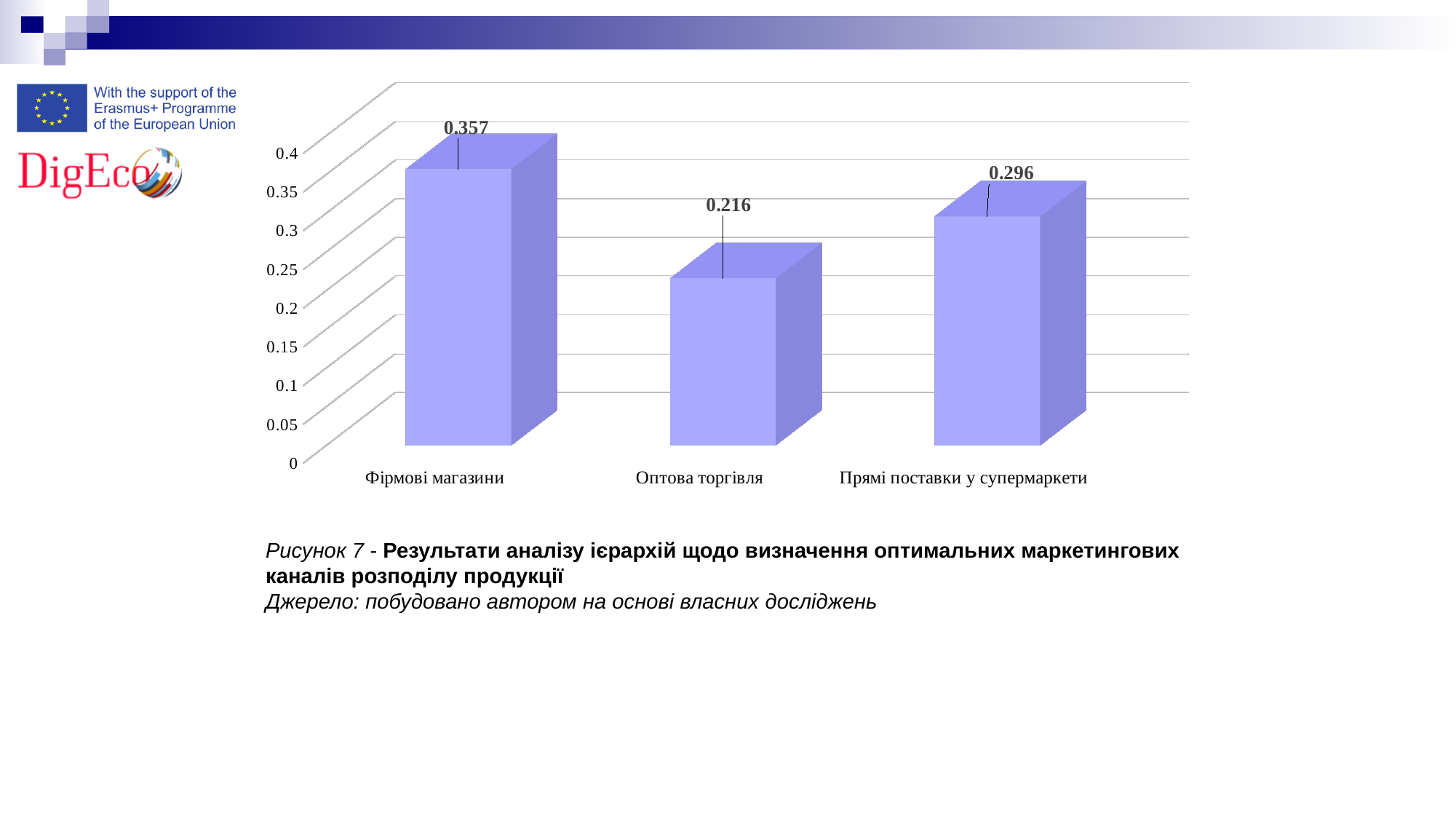
What is the difference between the values for Прямі поставки у супермаркети and Оптова торгівля? 0.080 What is the difference between the values for Фірмові магазини and Оптова торгівля? 0.141 Which is larger, the value for Прямі поставки у супермаркети or the value for Оптова торгівля? Прямі поставки у супермаркети What is the value for Прямі поставки у супермаркети? 0.296 What kind of chart is shown on the slide? bar chart How many categories are shown on the chart? 3 Which category has the lowest value? Оптова торгівля Which category has the highest value? Фірмові магазини What is the figure number given in the caption below the chart? Рисунок 7 What is the value for Фірмові магазини? 0.357 Is the value for Оптова торгівля greater or less than 0.25? less What is the value for Оптова торгівля? 0.216